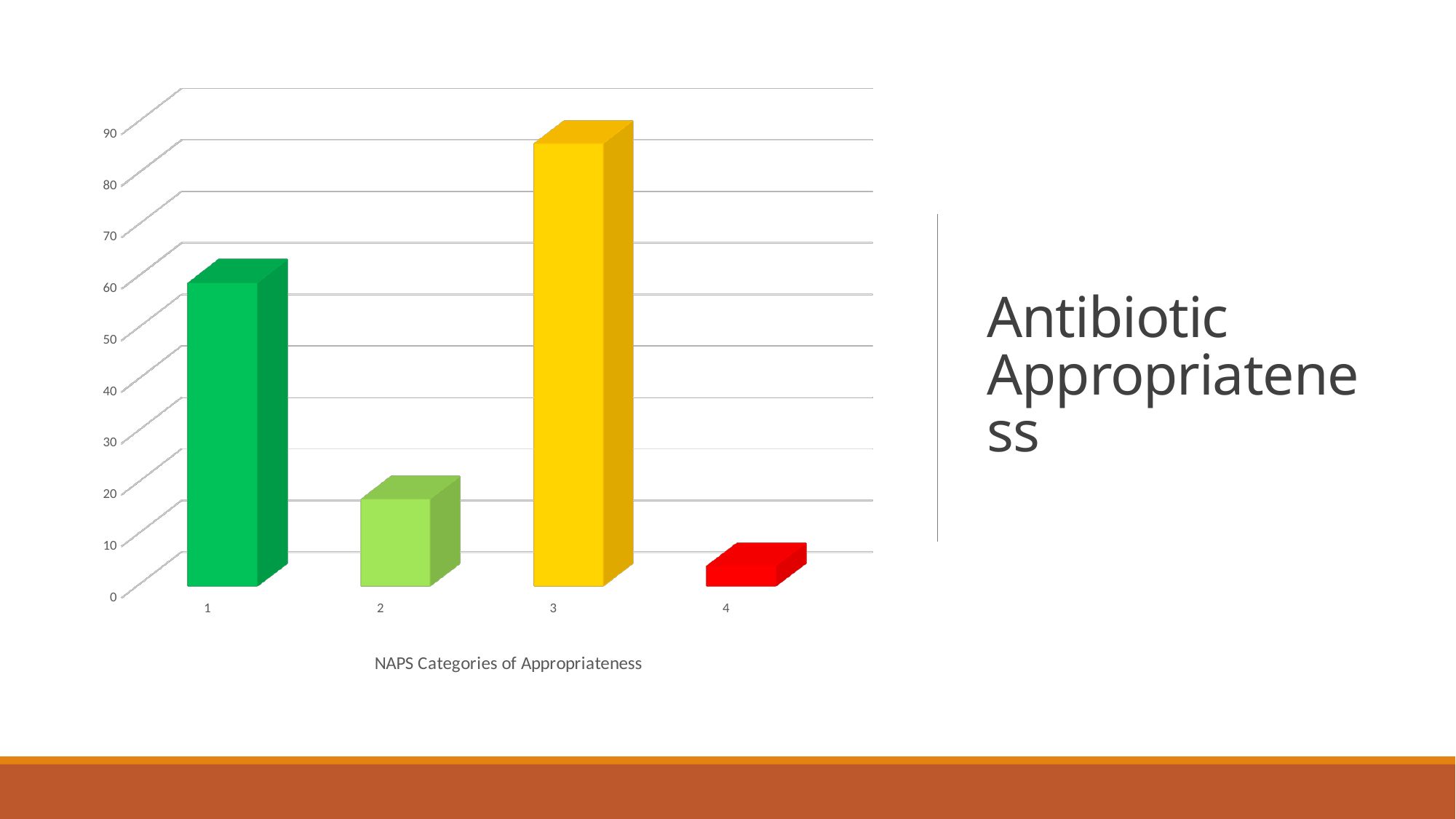
What is the title of the x axis? NAPS Categories of Appropriateness Which category has the lowest bar? 4 What colour is the bar for category 3? yellow Is the value for category 4 greater or less than 10? less Which is larger, the value for category 1 or category 2? 1 Is the value for category 3 greater or less than 80? greater Is the value for category 2 greater or less than 30? less Which is larger, the value for category 3 or category 1? 3 Which category has the highest bar? 3 How many categories are plotted on the x axis? 4 What kind of chart is shown on the slide? bar chart